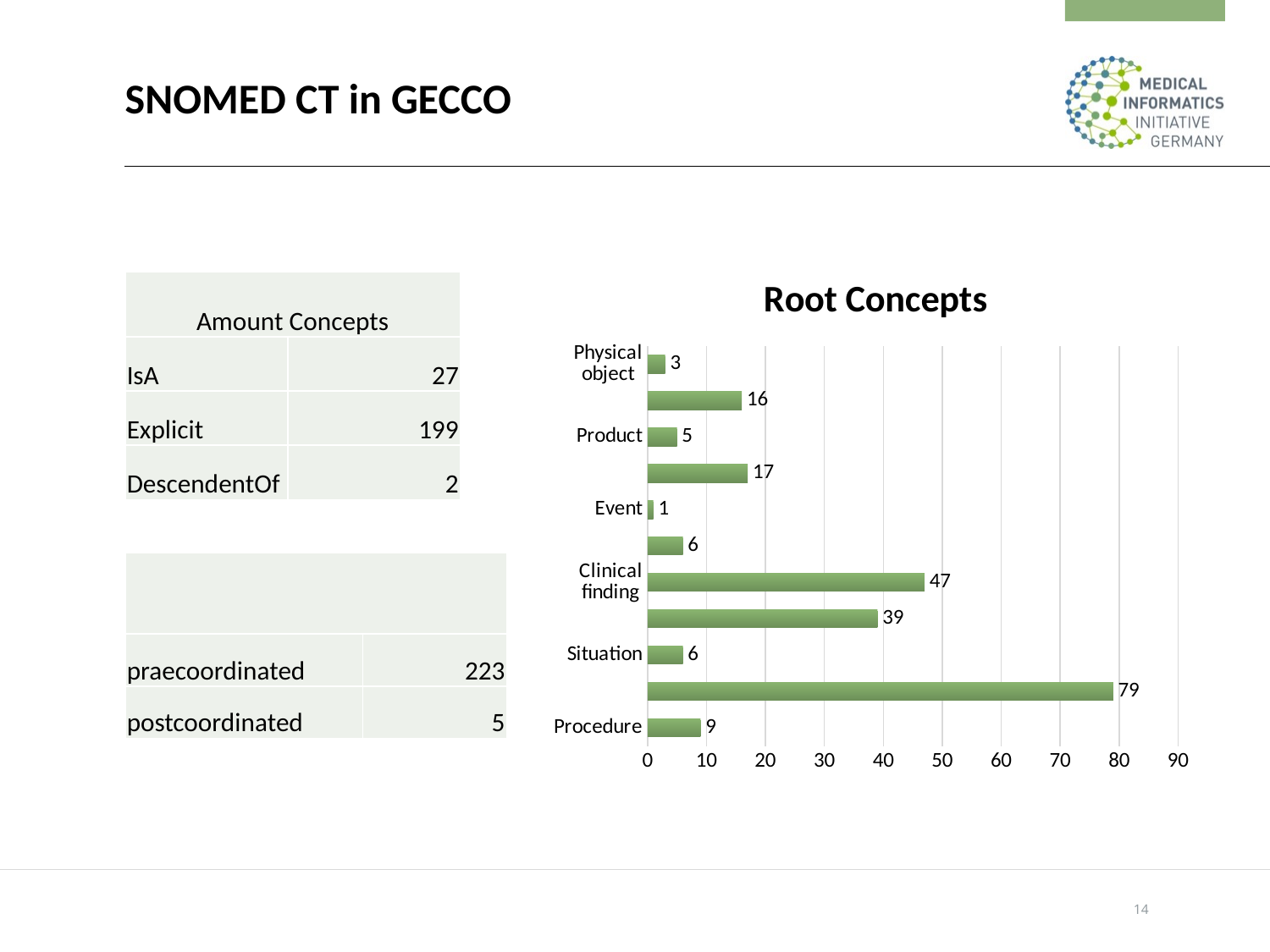
In the Root Concepts chart, which is larger, the value for Product or the value for Situation? Situation What kind of chart is the Root Concepts chart? Bar chart In the Root Concepts chart, what is the value for Physical object? 3 How many bars are plotted in the Root Concepts chart? 11 In the Root Concepts chart, is the value for Clinical finding greater or less than 40? greater In the Root Concepts chart, what is the largest value shown on any bar? 79 In the Root Concepts chart, what is the value for Clinical finding? 47 In the Root Concepts chart, what is the difference between the values for Clinical finding and Procedure? 38 In the Root Concepts chart, what is the value for Procedure? 9 In the Root Concepts chart, what is the value for Event? 1 In the Root Concepts chart, what is the value for Situation? 6 In the Root Concepts chart, which labelled category has the lowest value? Event